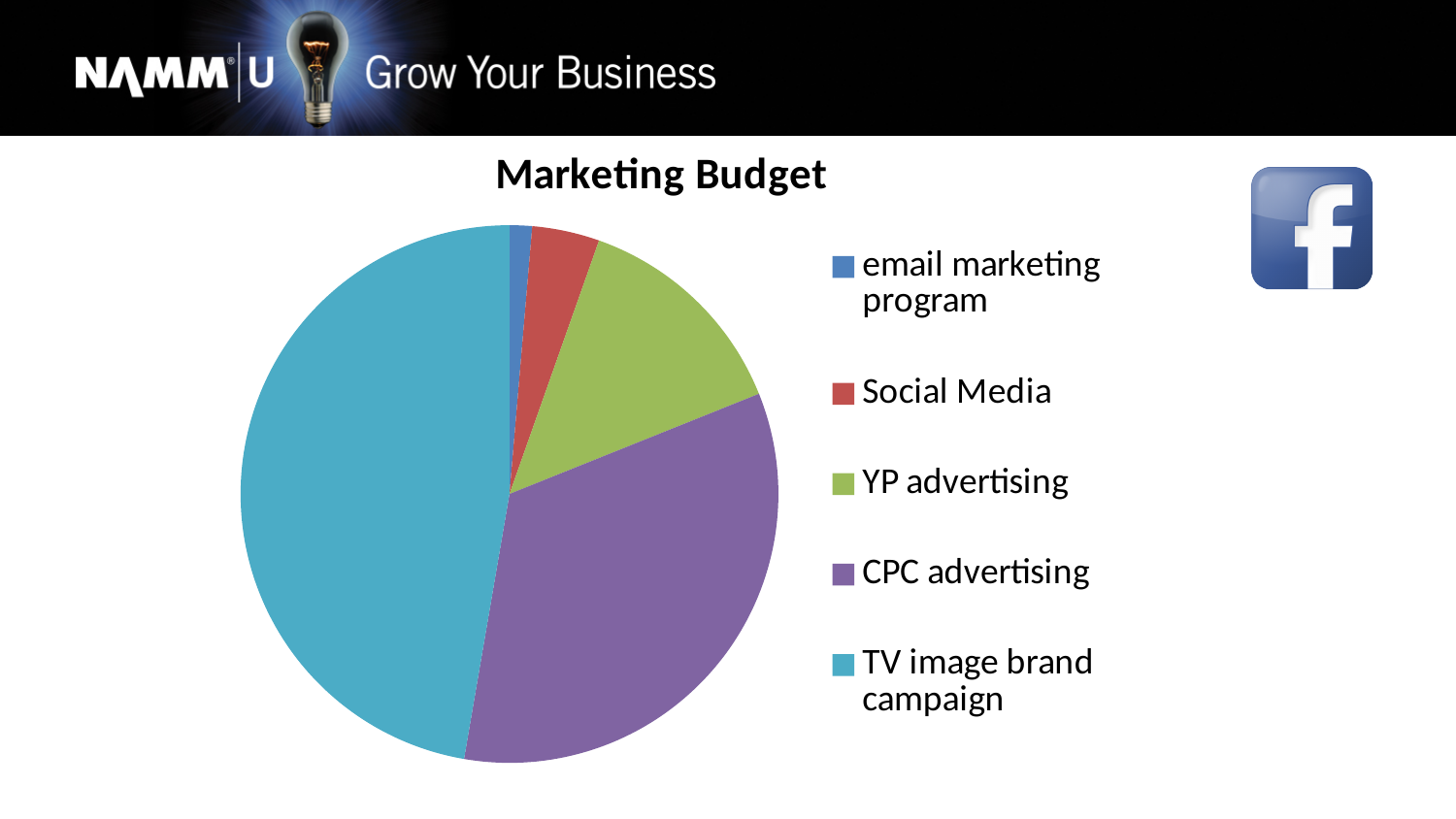
Which slice is larger, Social Media or YP advertising? YP advertising Which category has the largest slice of the pie? TV image brand campaign Which category is the second largest slice of the pie? CPC advertising What is the title of the chart? Marketing Budget Which category has the smallest slice of the pie? email marketing program Which slice is larger, CPC advertising or YP advertising? CPC advertising How many categories does the pie chart show? 5 Which slice is larger, email marketing program or Social Media? Social Media What type of chart is shown on the slide? pie chart What colour is the CPC advertising slice? purple